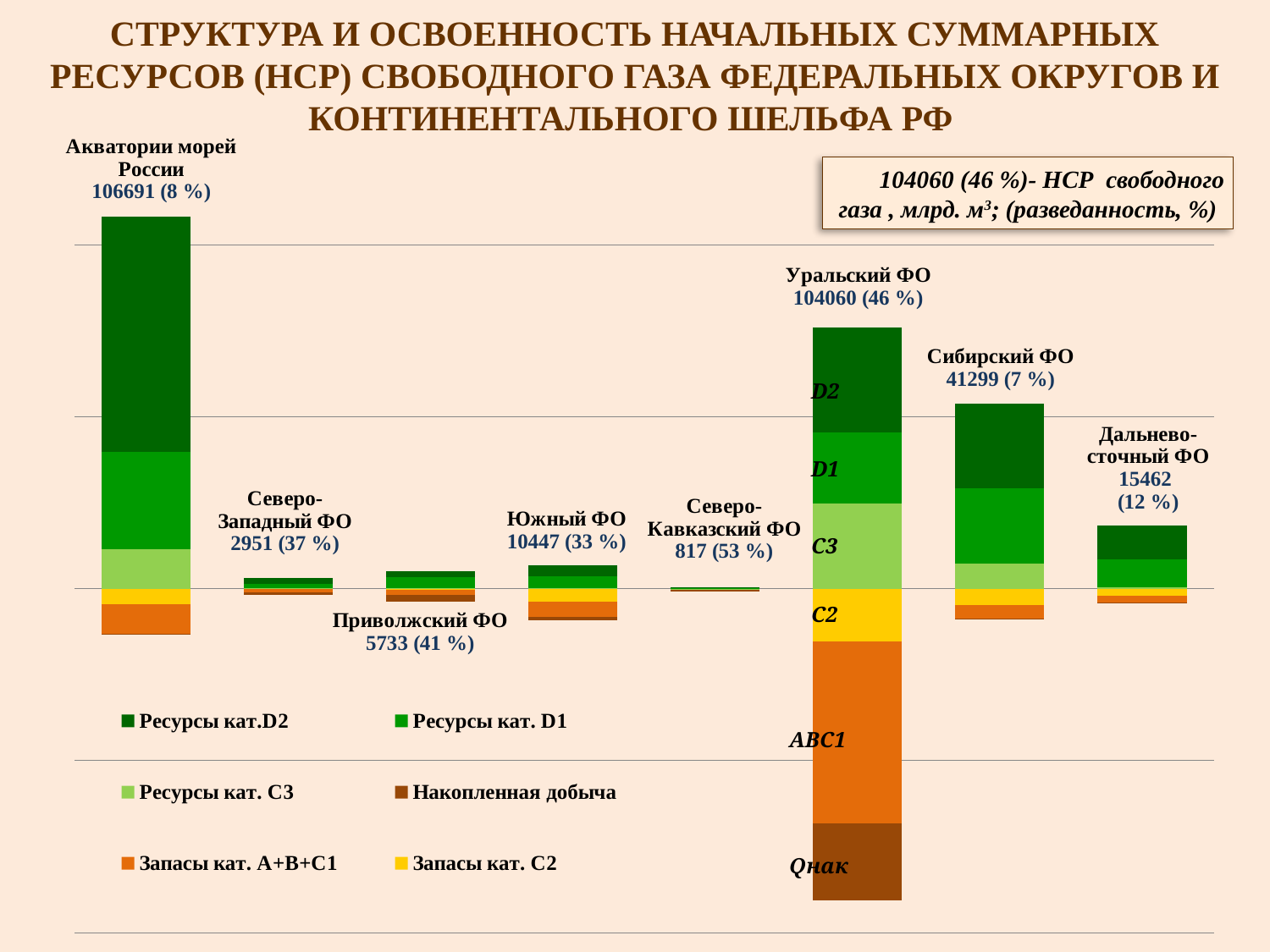
How many federal districts / regions (bars) are shown in the chart? 8 What НСР value is labeled for Уральский ФО? 104060 (46 %) Which region has the highest labeled НСР value? Акватории морей России Which has a larger labeled НСР value, Южный ФО or Приволжский ФО? Южный ФО What НСР value is labeled for Северо-Кавказский ФО? 817 (53 %) What НСР value is labeled for Акватории морей России? 106691 (8 %) Which region has the lowest labeled НСР value? Северо-Кавказский ФО How many series does the legend list? 6 What type of chart is shown on the slide? stacked bar chart Which region has the highest разведанность percentage shown in its label? Северо-Кавказский ФО (53 %) What is the difference between the labeled НСР values of Акватории морей России and Уральский ФО? 2631 What НСР value is labeled for Сибирский ФО? 41299 (7 %)